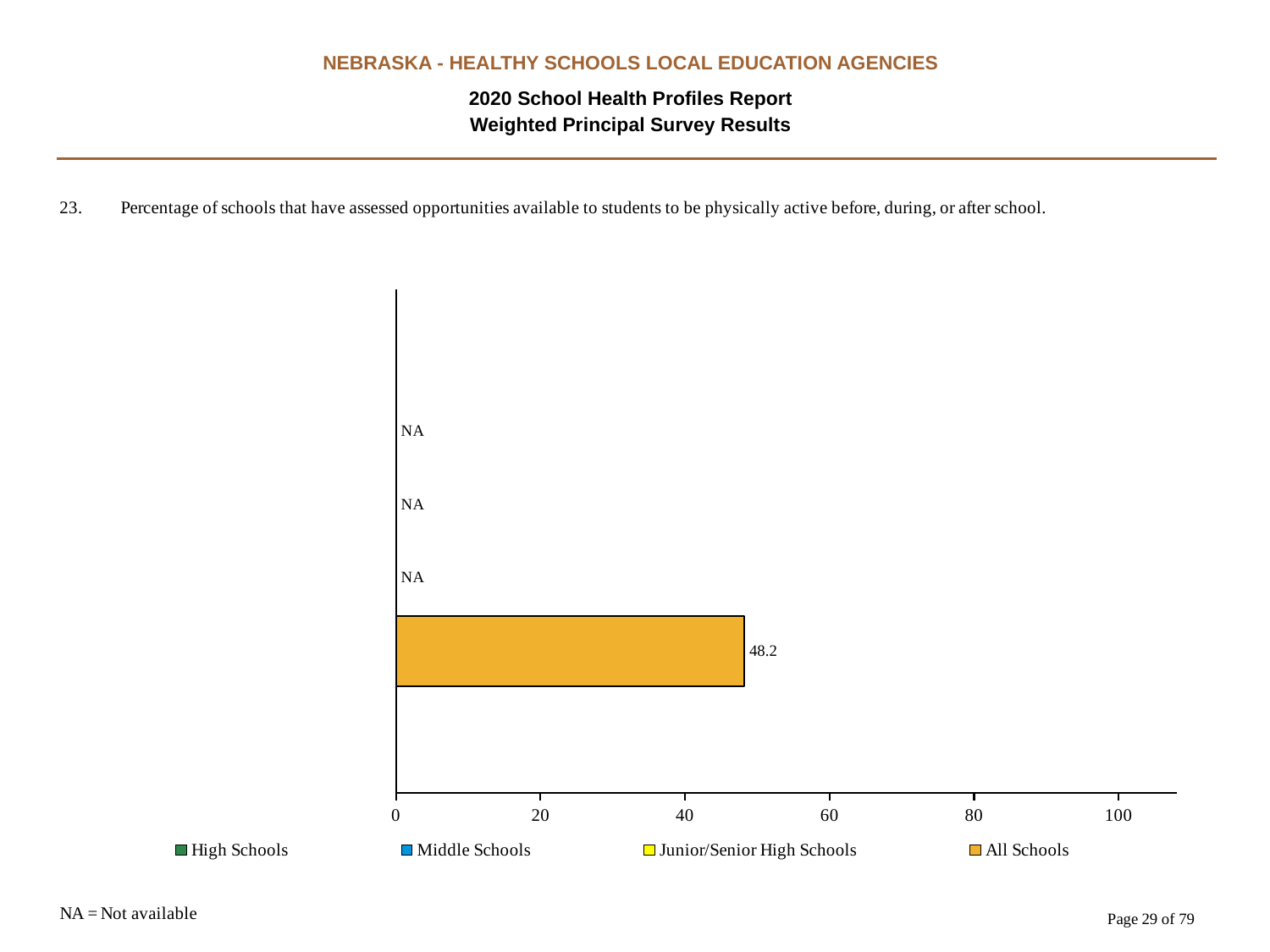
What is the value for All Schools? 48.2 What value is shown for Junior/Senior High Schools? NA Is the value for All Schools greater or less than 60? less What kind of chart is shown on the slide? bar chart How many series have a plotted bar with a numeric value? 1 What value is shown for Middle Schools? NA What value is shown for High Schools? NA How many series does the legend list? 4 What is the highest value shown on the x axis? 100 Is the value for All Schools greater or less than 40? greater What does NA stand for according to the note on the slide? Not available